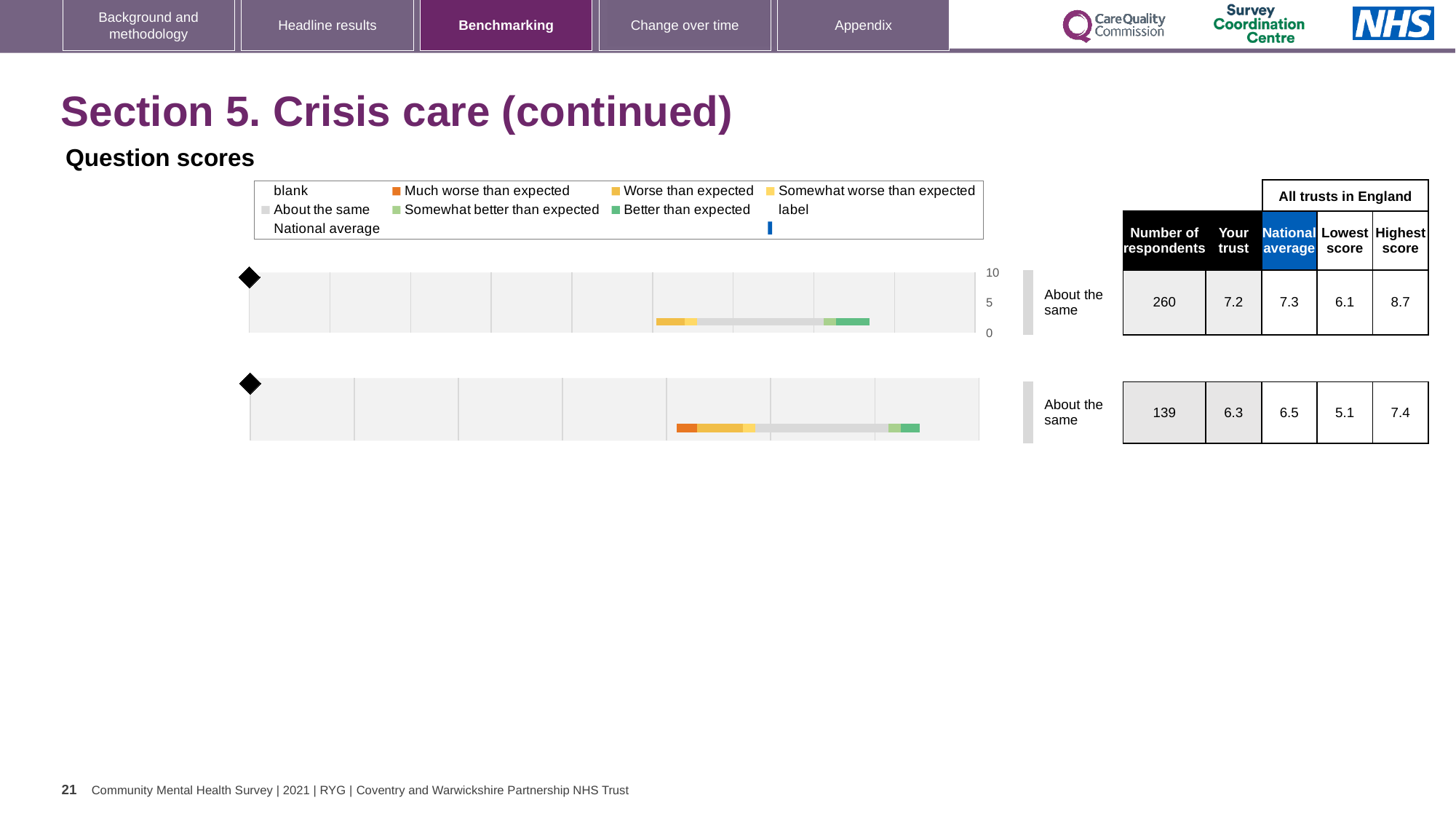
What kind of chart is used for the benchmarking bars on this slide? bar chart For the top chart, how many respondents are listed? 260 For the top chart, what is the difference between the highest score and the lowest score? 2.6 For the bottom chart, which is larger: the 'Your trust' score or the national average? National average For the bottom chart, what is the 'Your trust' score? 6.3 For the bottom chart, what is the difference between the national average and the 'Your trust' score? 0.2 For the top chart, what is the 'Your trust' score shown in the table? 7.2 How many benchmarking bar charts are shown on the slide? 2 For the top chart, what is the highest score among all trusts in England? 8.7 For the top chart, what is the national average score? 7.3 For the bottom chart, what is the lowest score among all trusts in England? 5.1 What benchmark category is the trust placed in for the top chart? About the same